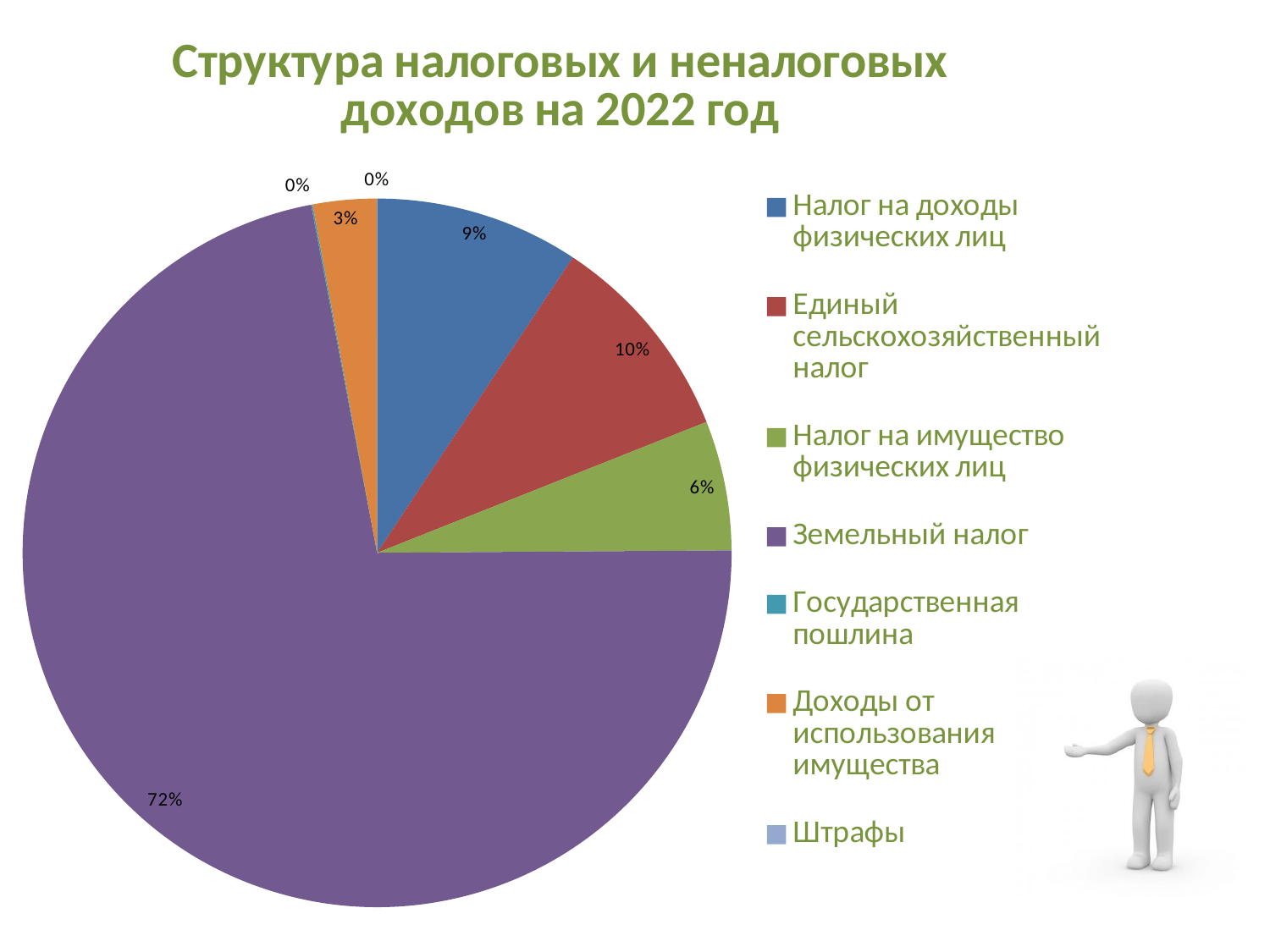
Which category has the largest share of the pie? Земельный налог What type of chart is shown on the slide? Pie chart Which is larger: the share for Единый сельскохозяйственный налог or the share for Налог на имущество физических лиц? Единый сельскохозяйственный налог What is the difference between the share for Земельный налог and the share for Единый сельскохозяйственный налог? 62% What colour is the slice for Земельный налог? Purple What share of the pie is Доходы от использования имущества? 3% How many categories does the legend list? 7 What share of the pie is Налог на доходы физических лиц? 9% What is the title of the chart? Структура налоговых и неналоговых доходов на 2022 год What share of the pie is Единый сельскохозяйственный налог? 10%